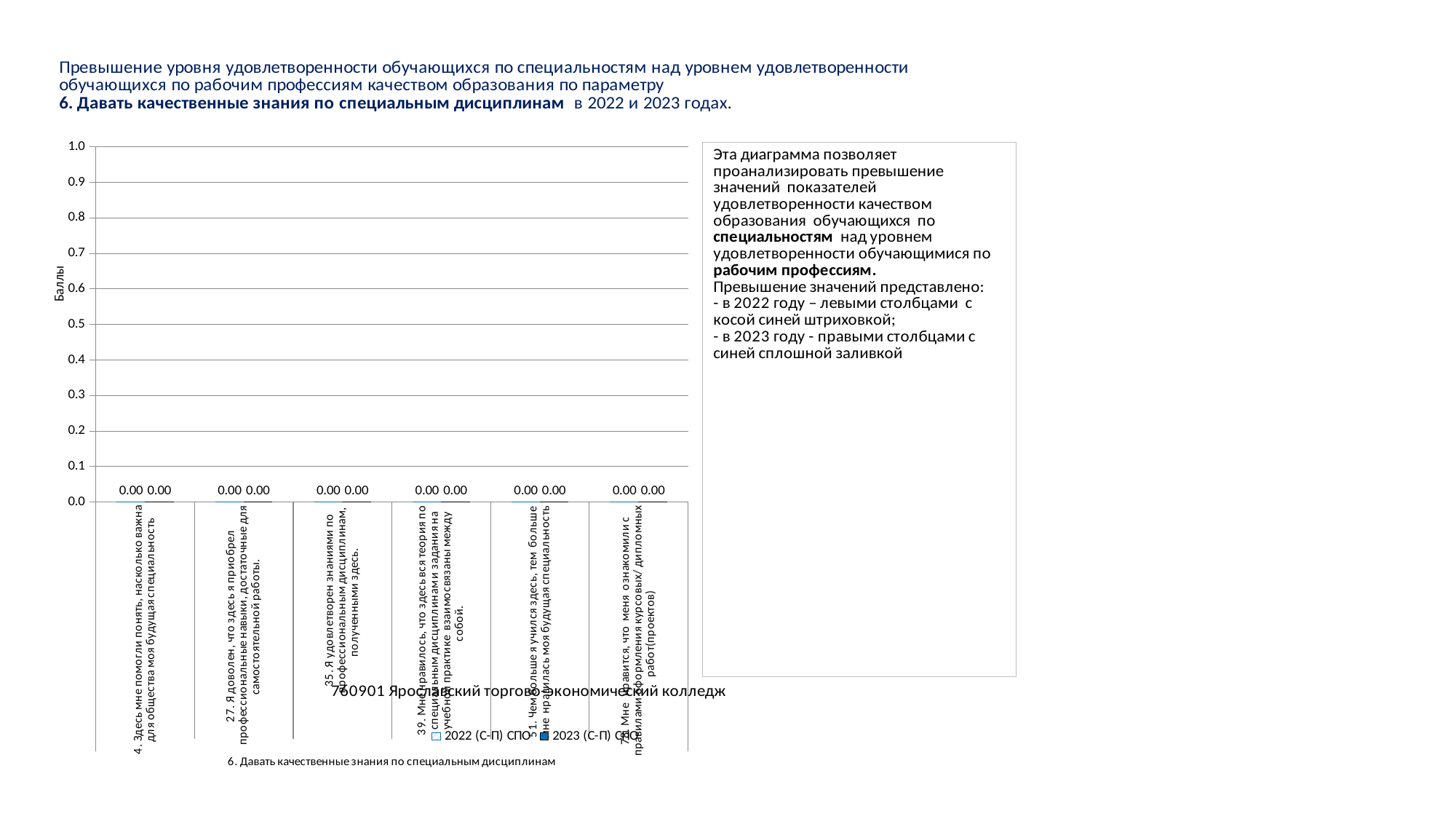
What is the label of the vertical axis of the chart? Баллы How many series does the chart legend list? 2 What are the two series names listed in the chart legend? 2022 (С-П) СПО and 2023 (С-П) СПО How many categories are shown on the x axis of the chart? 6 What is the value of the 2022 (С-П) СПО series for category 4 ("Здесь мне помогли понять, насколько важна для общества моя будущая специальность")? 0.00 What is the difference between the 2022 (С-П) СПО and 2023 (С-П) СПО values for category 51 ("Чем больше я учился здесь, тем больше мне нравилась моя будущая специальность")? 0.00 What type of chart is shown on the slide? bar chart What is the value of the 2022 (С-П) СПО series for category 35 ("Я удовлетворен знаниями по профессиональным дисциплинам, полученными здесь")? 0.00 Is the value of the 2023 (С-П) СПО series for category 39 greater or less than 0.5? less What is the value of the 2023 (С-П) СПО series for category 27 ("Я доволен, что здесь приобрел профессиональные навыки, достаточные для самостоятельной работы")? 0.00 What is the highest value shown on the vertical axis of the chart? 1.0